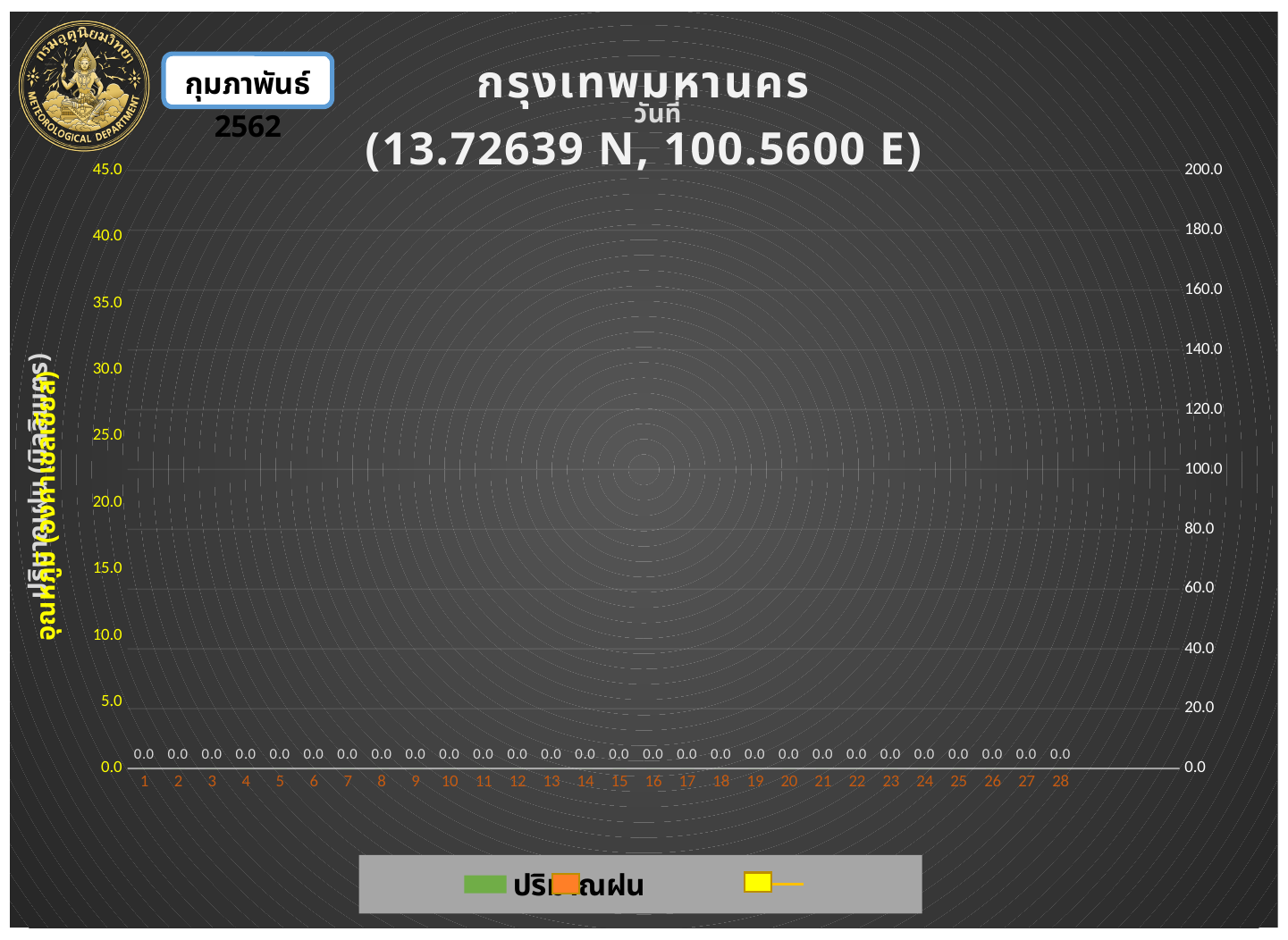
What is the data label value shown for day 14? 0.0 What is the data label value shown for day 1? 0.0 What is the highest tick value shown on the left vertical axis? 45.0 What is the data label value shown for day 28? 0.0 Do the plotted values rise, fall, or stay flat across the days on the x axis? stay flat What is the highest tick value shown on the right vertical axis? 200.0 What is the difference between the values for day 3 and day 25? 0.0 What is the last day number shown on the x axis? 28 How many days (categories) are shown along the x axis? 28 Is the value for day 10 greater or less than 5.0? less What is the first day number shown on the x axis? 1 Is the value for day 20 greater or less than 20.0? less